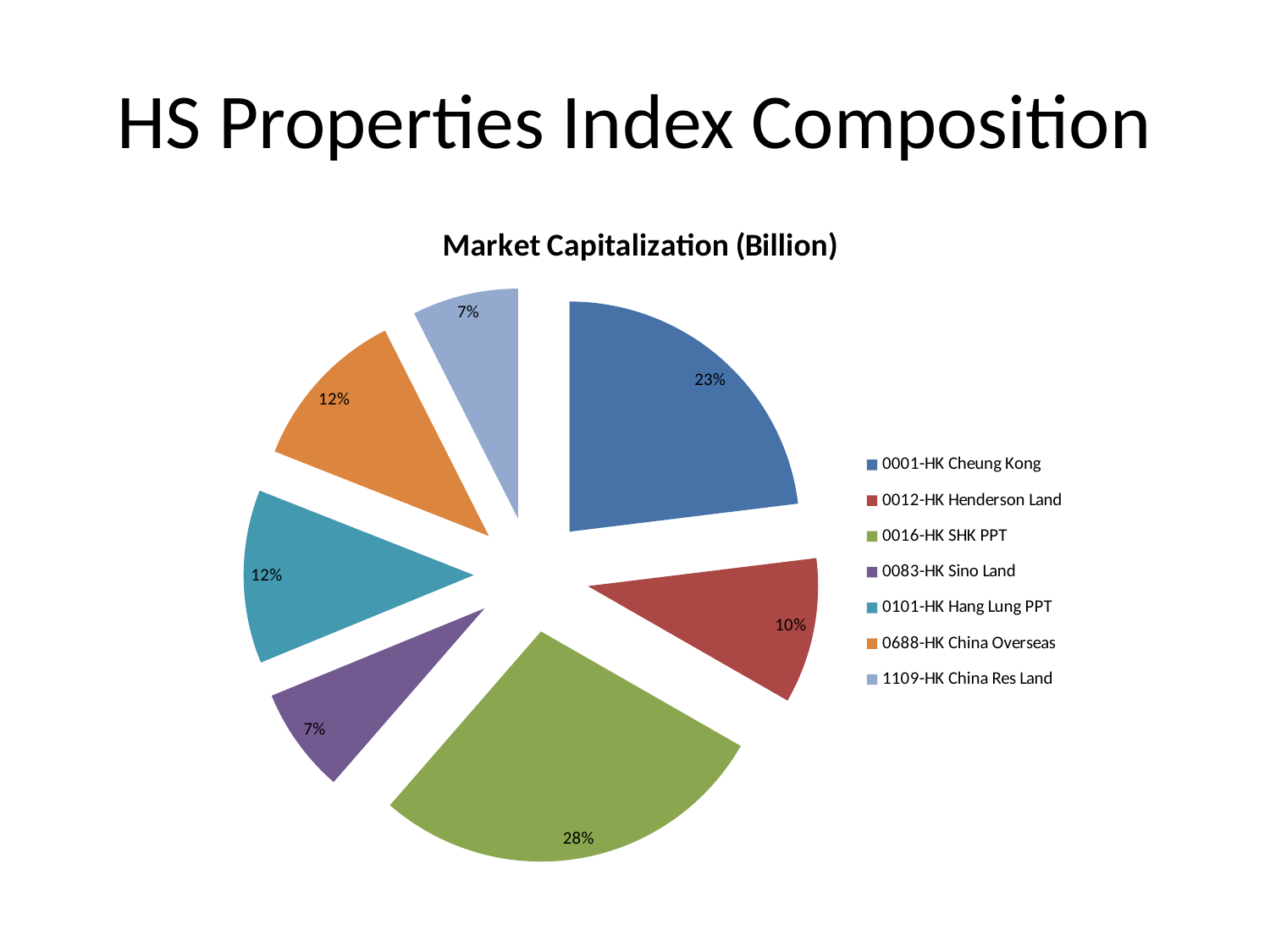
What is the difference in percentage points between the shares of 0016-HK SHK PPT and 0001-HK Cheung Kong? 5 percentage points What share of the pie does 0012-HK Henderson Land hold? 10% What share of the pie does 0016-HK SHK PPT hold? 28% What share of the pie does 0001-HK Cheung Kong hold? 23% Which company has the largest share of the pie? 0016-HK SHK PPT Which has the larger share, 0001-HK Cheung Kong or 0688-HK China Overseas? 0001-HK Cheung Kong Which colour represents 0688-HK China Overseas in the legend? orange What is the difference in percentage points between the shares of 0101-HK Hang Lung PPT and 0083-HK Sino Land? 5 percentage points How many slices does the pie chart have? 7 What is the title of the chart? Market Capitalization (Billion) What kind of chart is shown on the slide? pie chart